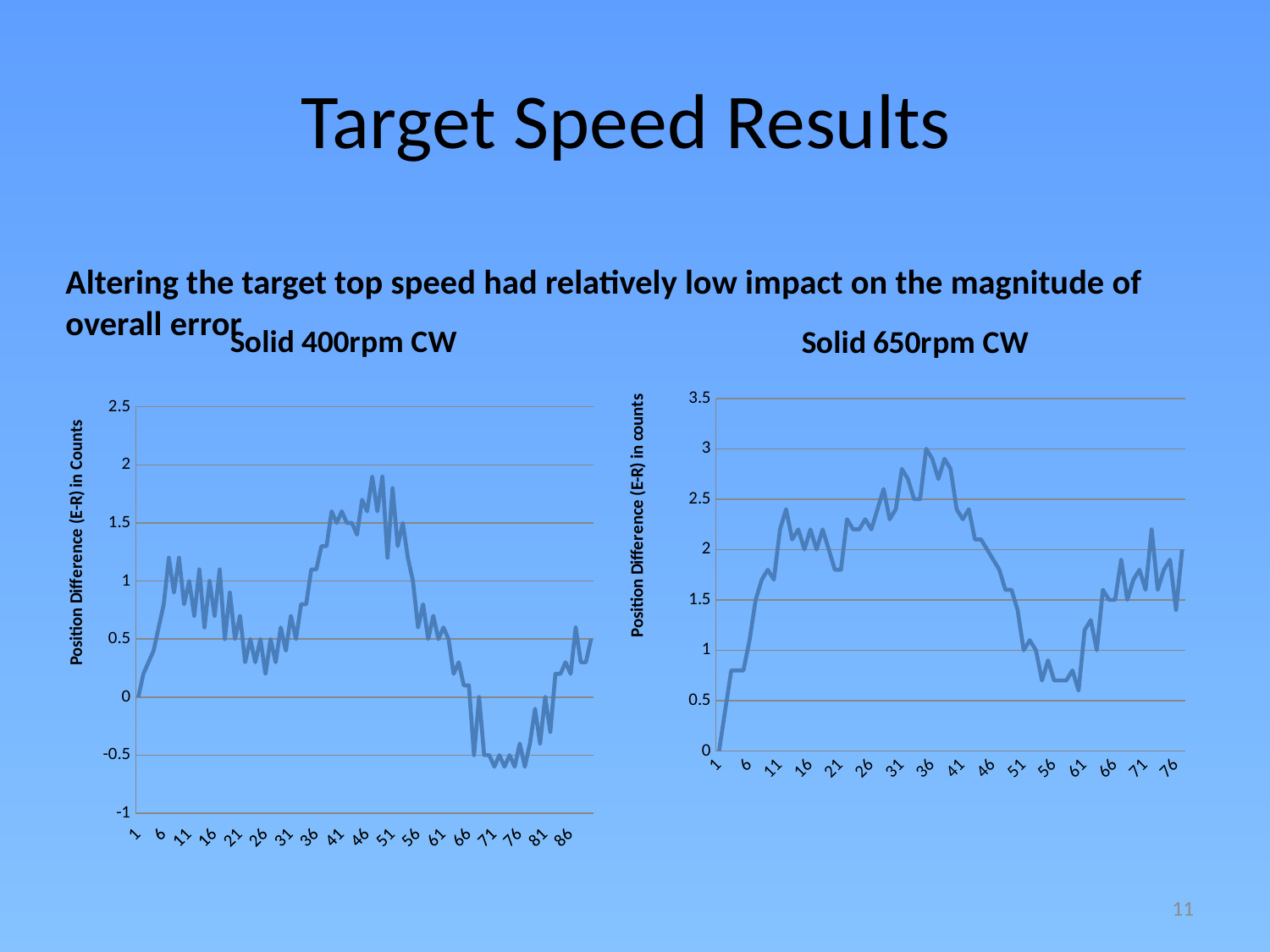
Which chart reaches a higher maximum value, 'Solid 400rpm CW' or 'Solid 650rpm CW'? Solid 650rpm CW In the 'Solid 650rpm CW' chart, is the value at x = 11 greater or less than 2? greater In the 'Solid 650rpm CW' chart, do the values rise or fall between x = 36 and x = 56? fall In the 'Solid 650rpm CW' chart, is the value at x = 36 greater or less than 2.5? greater What kind of chart is the 'Solid 400rpm CW' chart? line chart In the 'Solid 400rpm CW' chart, do the values rise or fall between x = 1 and x = 6? rise What is the y-axis title of the 'Solid 650rpm CW' chart? Position Difference (E-R) in counts In the 'Solid 650rpm CW' chart, is the value at x = 56 greater or less than 1? less What is the highest y-axis tick shown on the 'Solid 400rpm CW' chart? 2.5